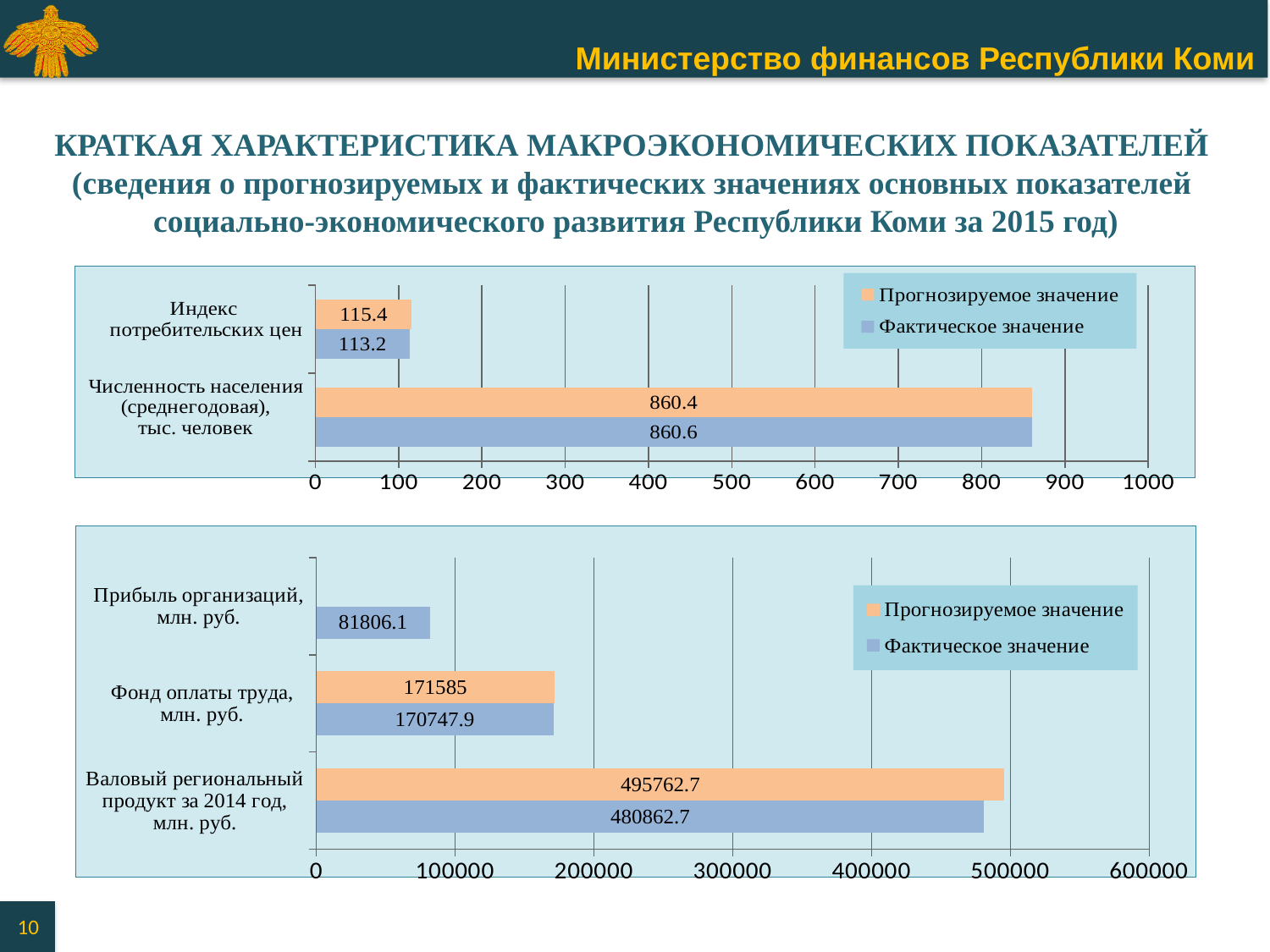
How many categories are shown in the bottom chart? 3 In the bottom chart, which category has the highest actual value? Валовый региональный продукт за 2014 год, млн. руб. In the top chart, by how much does the forecast value for Индекс потребительских цен exceed the actual value? 2.2 In the bottom chart, what is the forecast value for Фонд оплаты труда, млн. руб.? 171585 In the top chart, is the actual value for Численность населения greater or less than 800? greater How many series does the legend of the top chart list? 2 In the top chart, what is the forecast value (Прогнозируемое значение) for Индекс потребительских цен? 115.4 In the bottom chart, what is the difference between the forecast and actual values for Валовый региональный продукт за 2014 год, млн. руб.? 14900 In the top chart, what is the actual value (Фактическое значение) for Численность населения (среднегодовая), тыс. человек? 860.6 In the bottom chart, which is larger for Фонд оплаты труда: the forecast value or the actual value? The forecast value (171585) In the bottom chart, what is the actual value for Прибыль организаций, млн. руб.? 81806.1 What kind of chart is the bottom chart? Bar chart